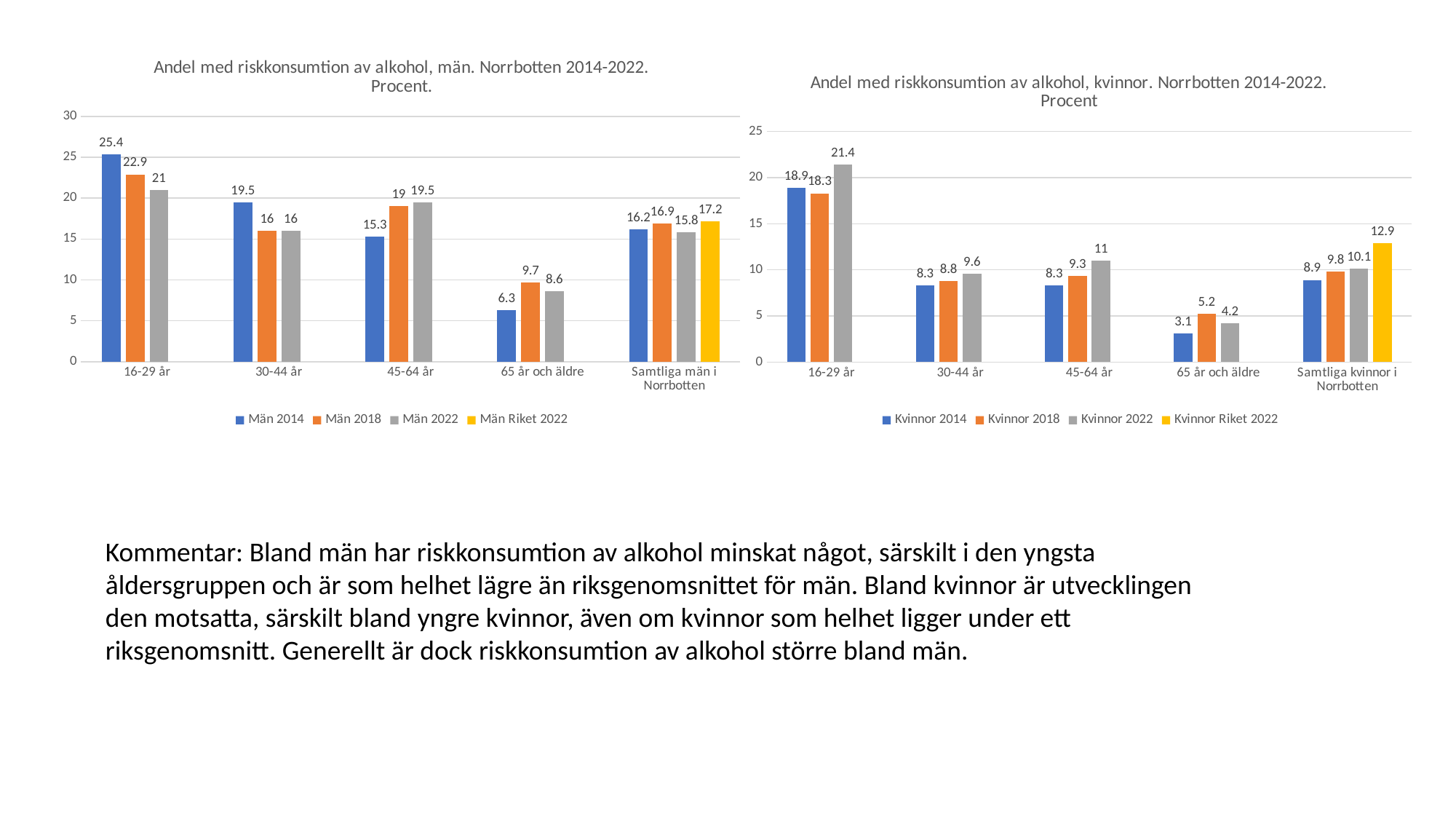
In the left chart (men), which is larger for 45-64 år: Män 2014 or Män 2022? Män 2022 In the left chart (men), what is the difference between Män 2014 and Män 2022 in the 16-29 år group? 4.4 In the right chart (women), what is the value for Kvinnor Riket 2022 for Samtliga kvinnor i Norrbotten? 12.9 How many categories are shown on the x axis of the left chart (men)? 5 In the right chart (women), which category has the highest value for Kvinnor 2022? 16-29 år In the left chart (men), which age group has the lowest value for Män 2022? 65 år och äldre What type of chart is the left chart (men)? Bar chart How many series does the legend of the right chart (women) list? 4 In the left chart (men), what is the value for Män 2014 in the 16-29 år group? 25.4 In the right chart (women), is the value for Kvinnor 2018 in the 65 år och äldre group greater or less than 10? less In the right chart (women), what is the difference between Kvinnor 2022 and Kvinnor 2014 in the 16-29 år group? 2.5 In the right chart (women), what is the title of the chart? Andel med riskkonsumtion av alkohol, kvinnor. Norrbotten 2014-2022. Procent